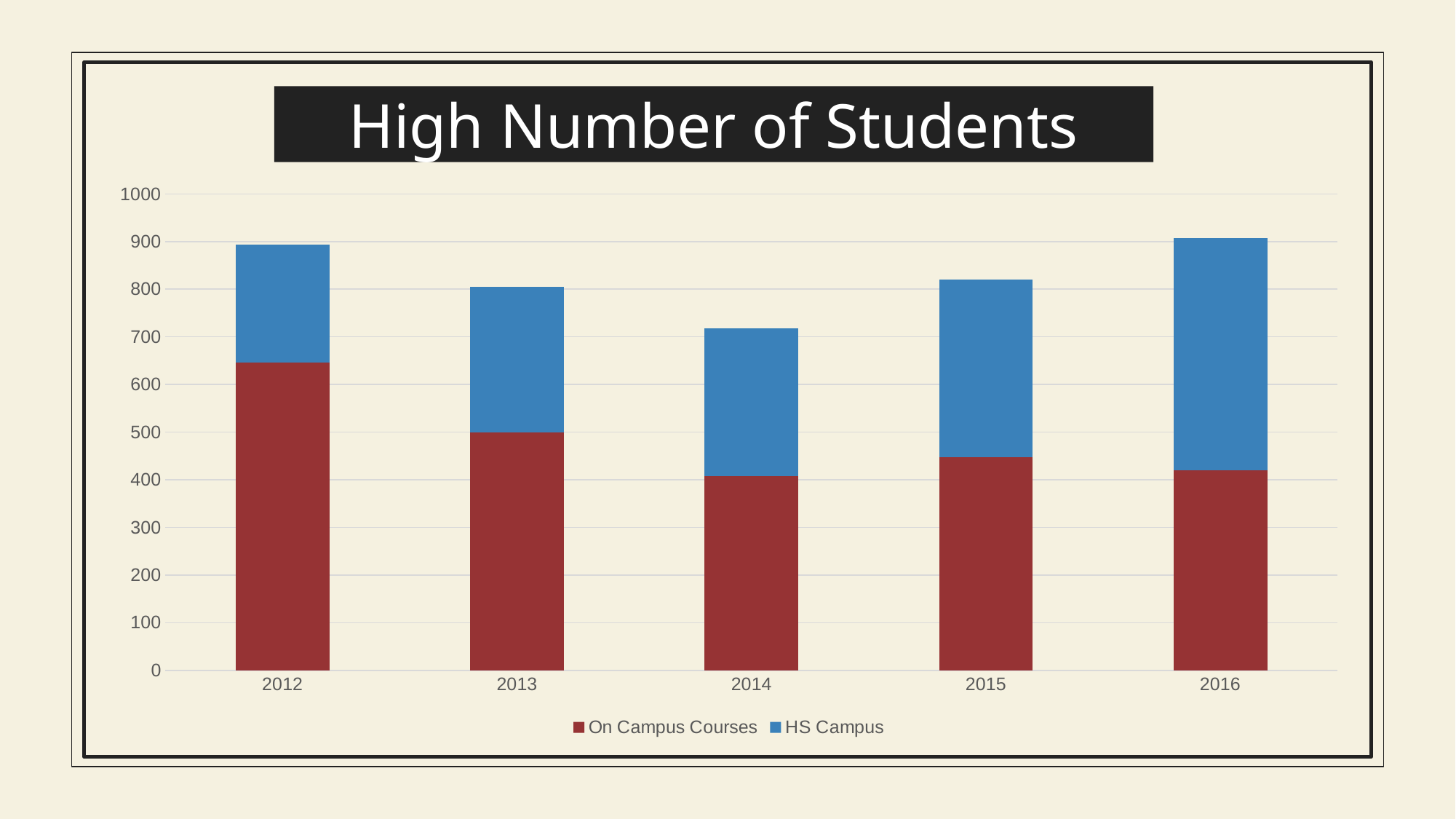
Which year has the smallest HS Campus segment? 2012 Which year has the larger total number of students, 2015 or 2014? 2015 How many series does the legend list? 2 What is the title of the chart? High Number of Students How many years are shown on the x axis? 5 Which year has the highest value for On Campus Courses? 2012 Is the On Campus Courses value for 2012 greater or less than 600? greater Is the total for 2014 greater or less than 800? less Which year has the largest HS Campus segment? 2016 What kind of chart is shown on the slide? Stacked bar chart Which year has the lowest total number of students? 2014 Is the On Campus Courses value for 2015 greater or less than 500? less